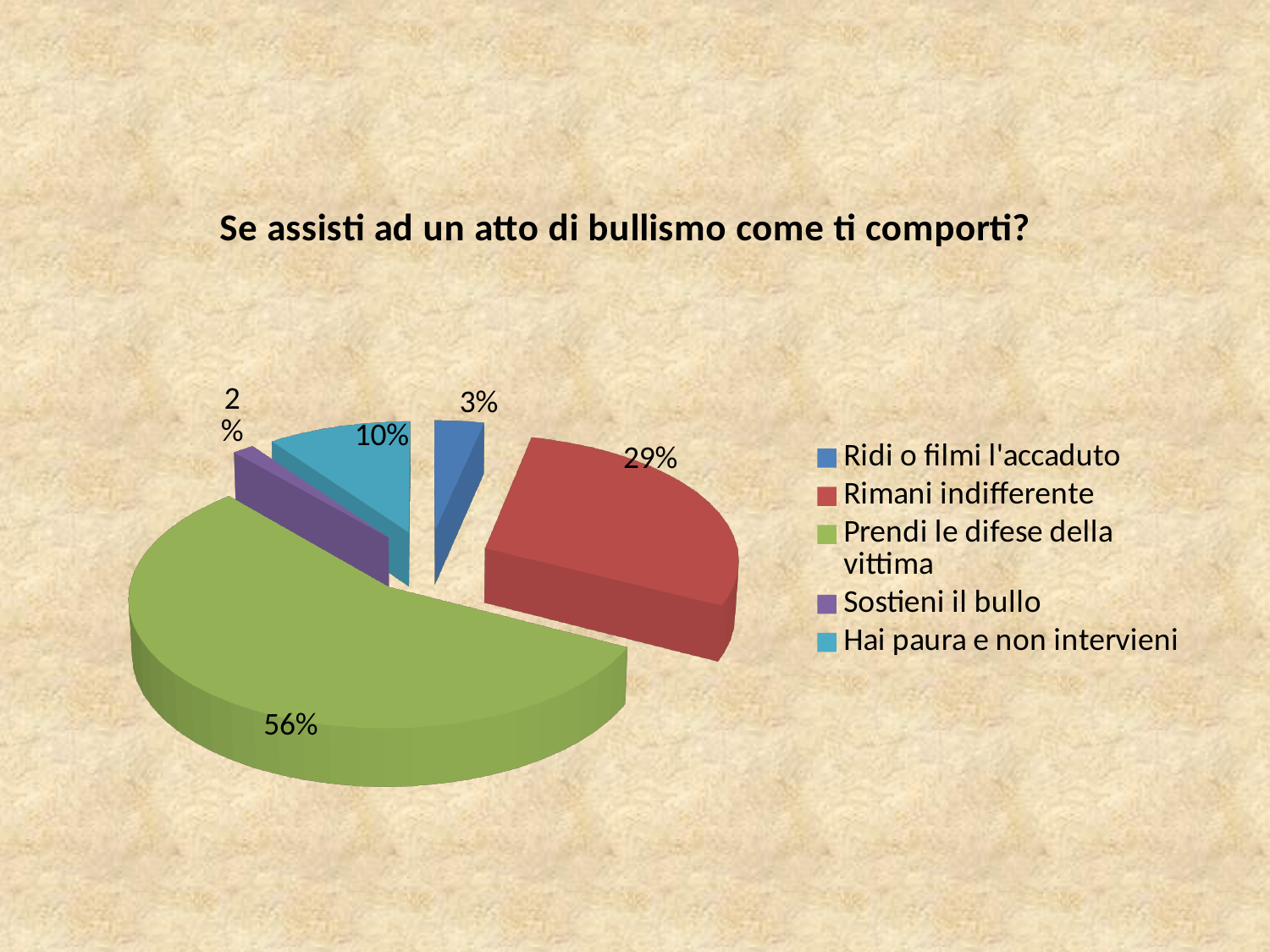
What is the difference in percentage points between "Prendi le difese della vittima" and "Rimani indifferente"? 27 What percentage of respondents chose "Hai paura e non intervieni"? 10% How many categories does the pie chart show? 5 Which response has the smallest share of the pie? Sostieni il bullo Which response has the largest share of the pie? Prendi le difese della vittima What type of chart is shown on the slide? Pie chart What percentage of respondents chose "Prendi le difese della vittima"? 56% What percentage of respondents chose "Rimani indifferente"? 29% What percentage of respondents chose "Ridi o filmi l'accaduto"? 3% What is the title of the chart? Se assisti ad un atto di bullismo come ti comporti? What percentage of respondents chose "Sostieni il bullo"? 2% Which is larger: the share for "Hai paura e non intervieni" or the share for "Ridi o filmi l'accaduto"? Hai paura e non intervieni